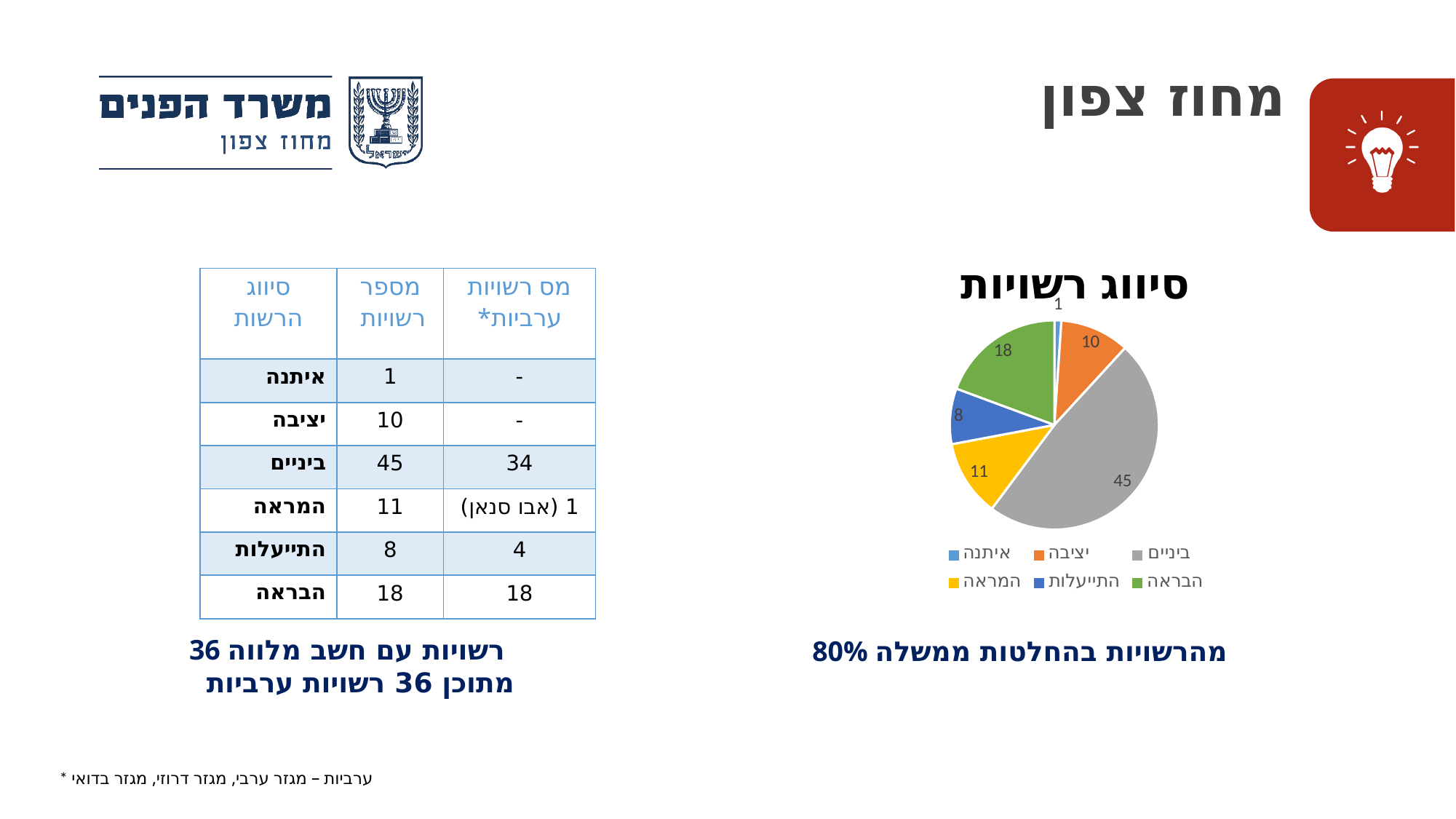
In the pie chart "סיווג רשויות", what colour is the slice for ביניים? grey What kind of chart is shown under the title "סיווג רשויות"? pie chart In the pie chart "סיווג רשויות", what is the value for התייעלות? 8 In the pie chart "סיווג רשויות", which category has the smallest slice? איתנה In the pie chart "סיווג רשויות", which is larger, the value for המראה or the value for התייעלות? המראה In the pie chart "סיווג רשויות", what is the difference between the values for ביניים and הבראה? 27 How many categories does the pie chart "סיווג רשויות" show? 6 What is the total of all the values shown in the pie chart "סיווג רשויות"? 93 In the pie chart "סיווג רשויות", which category has the largest slice? ביניים In the pie chart "סיווג רשויות", what is the value for הבראה? 18 In the pie chart "סיווג רשויות", what is the value for יציבה? 10 In the pie chart "סיווג רשויות", what is the value for ביניים? 45